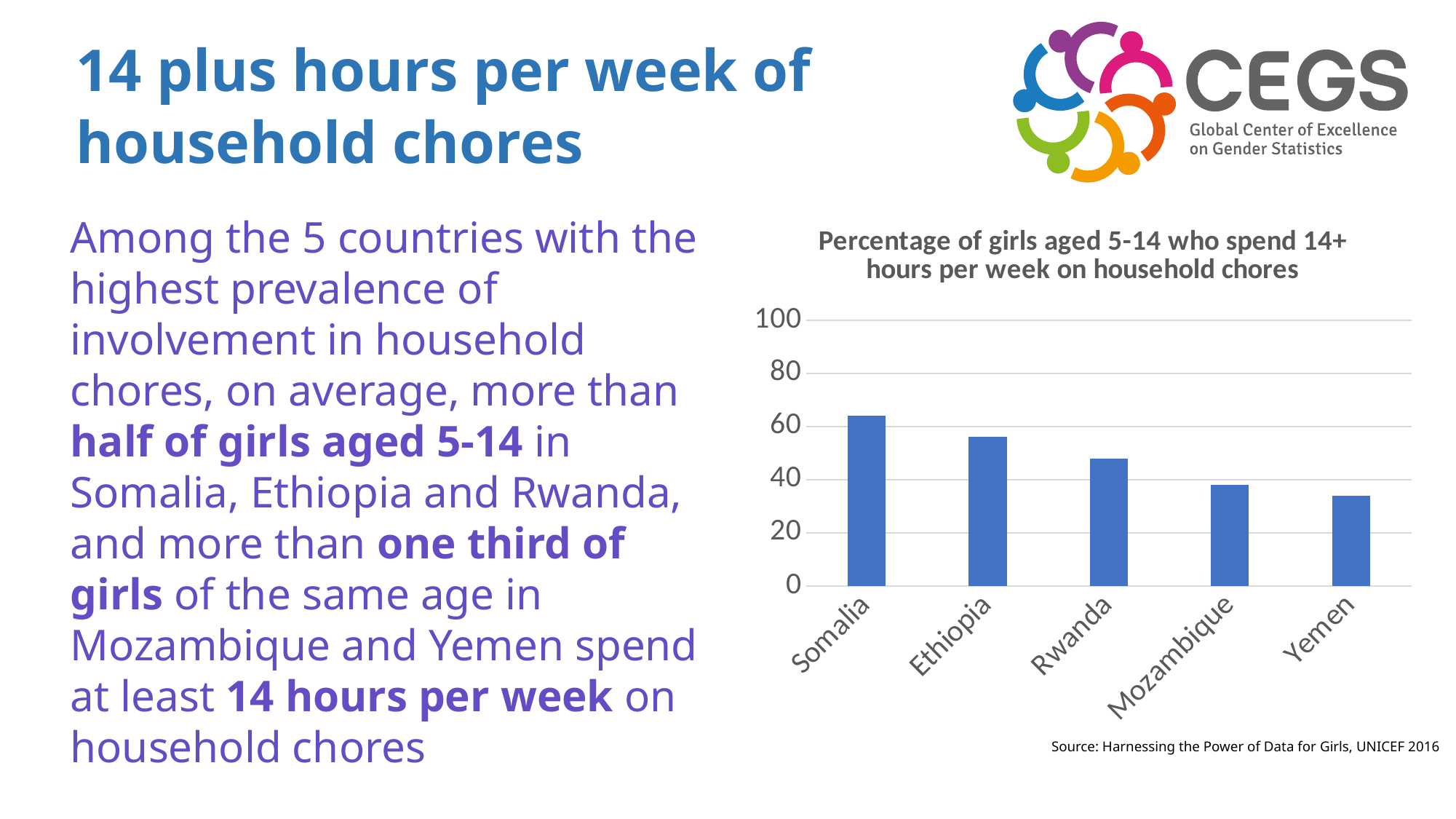
How many countries are shown on the chart? 5 What kind of chart is shown on the slide? bar chart Do the values rise or fall moving from Somalia to Yemen along the x axis? fall What is the title of the chart? Percentage of girls aged 5-14 who spend 14+ hours per week on household chores Is the value for Ethiopia greater or less than 60? less Is the value for Somalia greater or less than 60? greater Is the value for Yemen greater or less than 40? less Which country has the lowest percentage of girls aged 5-14 spending 14+ hours per week on household chores? Yemen Which country has the highest percentage of girls aged 5-14 spending 14+ hours per week on household chores? Somalia Which is larger, the value for Somalia or the value for Rwanda? Somalia